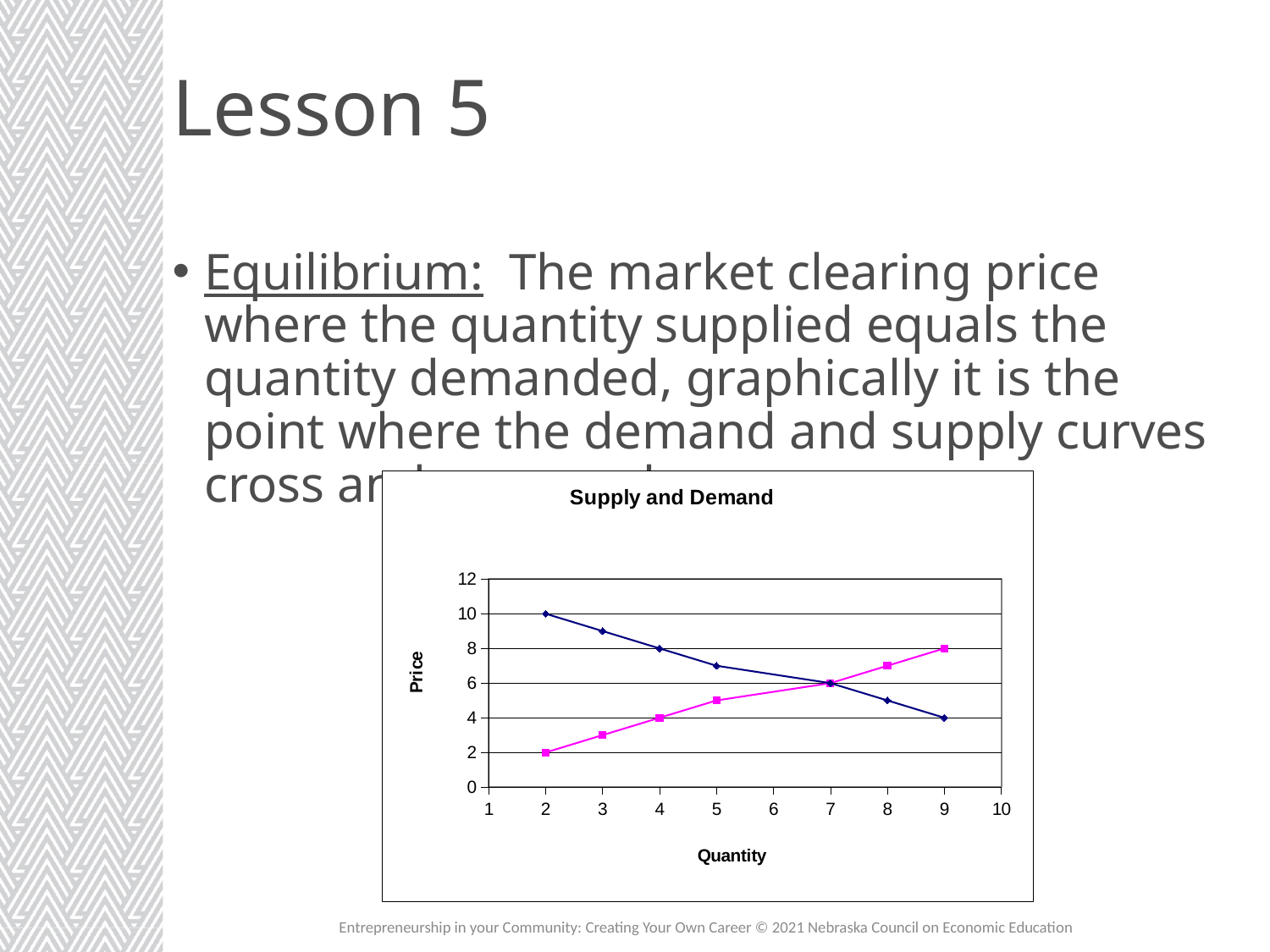
Does the blue line rise or fall as quantity increases? fall Does the pink line rise or fall as quantity increases? rise Is the price on the pink line at quantity 8 greater or less than 6? greater What is the title of the chart? Supply and Demand What is the price on the blue line at quantity 9? 4 What is the price on the blue (downward-sloping) line at quantity 2? 10 At what quantity do the two lines cross? 7 At quantity 3, which line has the higher price, the blue line or the pink line? blue line What is the label on the vertical axis of the chart? Price What kind of chart is shown on the slide? line chart What is the price on the pink (upward-sloping) line at quantity 2? 2 What is the price at the point where the two lines cross? 6